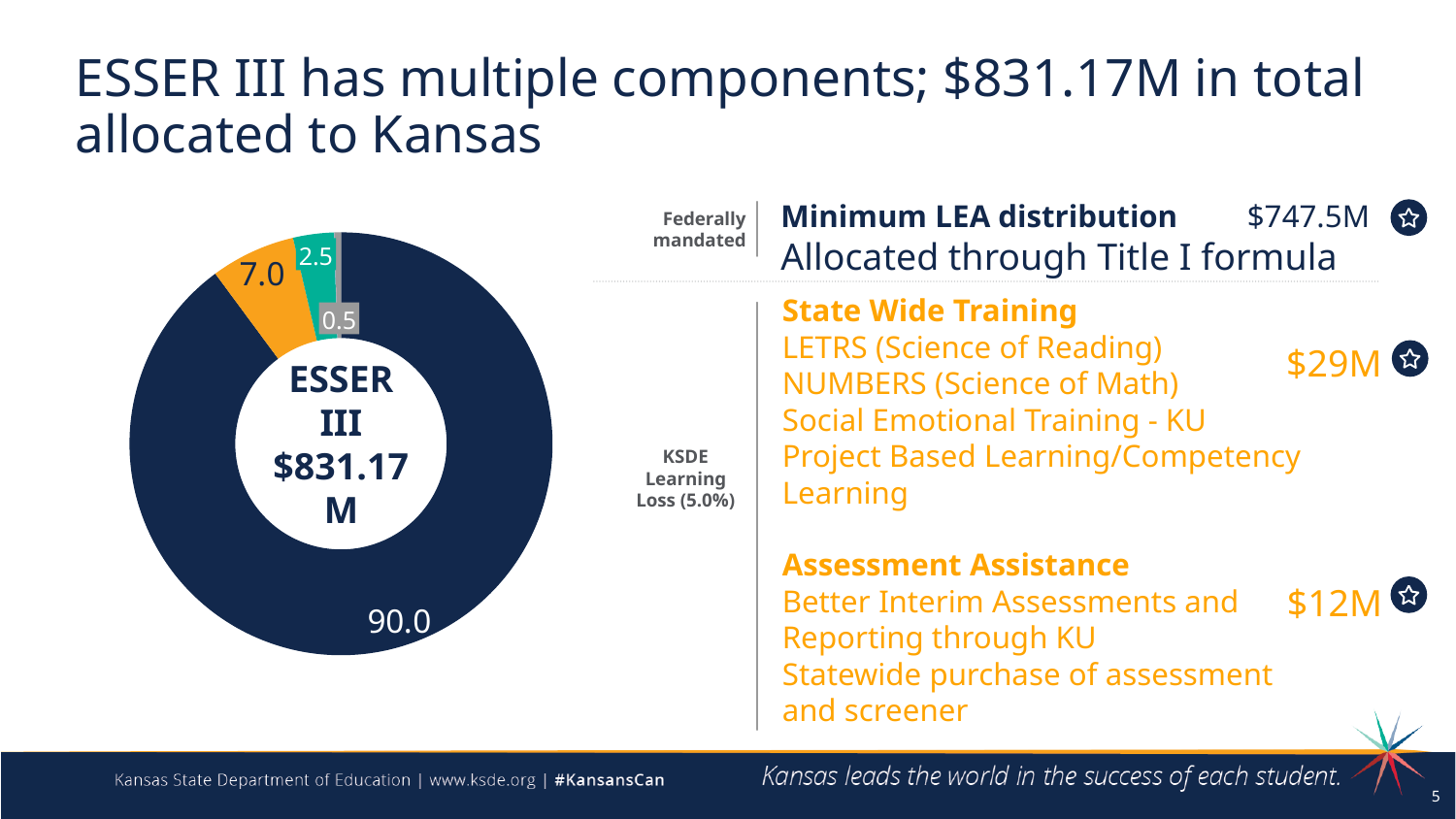
Which slice is larger in the doughnut chart, the orange slice or the teal slice? the orange slice What is the value labelled on the teal slice of the doughnut chart? 2.5 What is the value labelled on the dark navy slice of the doughnut chart? 90.0 What text is printed in the centre of the doughnut chart? ESSER III $831.17 M What is the sum of all four slice labels in the doughnut chart? 100.0 What kind of chart is shown on the left of the slide? doughnut chart What is the value of the largest slice in the doughnut chart? 90.0 What is the difference between the largest slice (90.0) and the orange slice (7.0) in the doughnut chart? 83.0 What is the difference between the teal slice (2.5) and the gray slice (0.5) in the doughnut chart? 2.0 What is the value of the smallest slice in the doughnut chart? 0.5 How many slices does the doughnut chart have? 4 What is the value labelled on the orange slice of the doughnut chart? 7.0